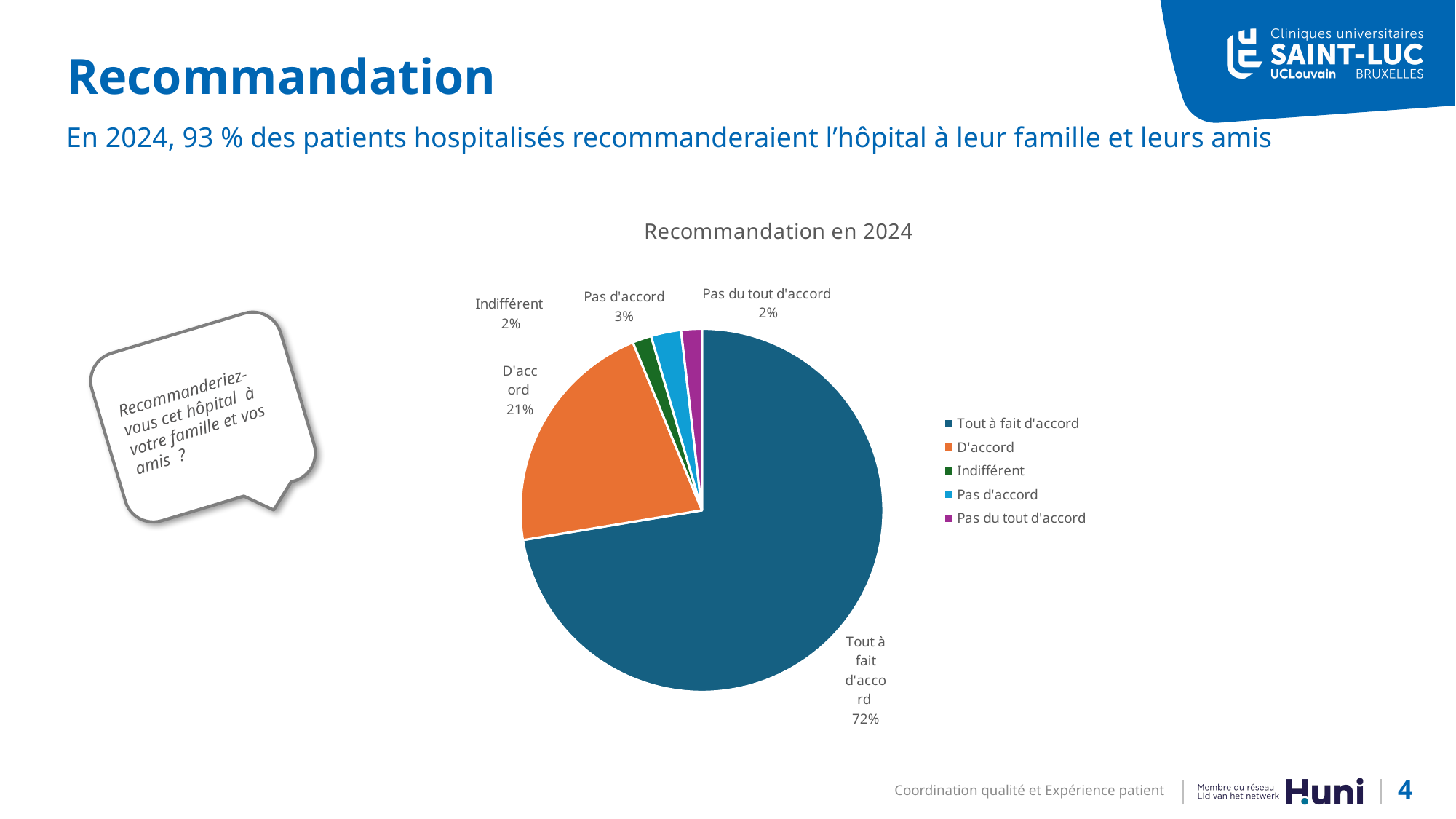
What share of the pie is labelled "Indifférent"? 2% What share of the pie is labelled "D'accord"? 21% How many categories does the legend list? 5 Which colour represents "Pas du tout d'accord" in the legend? purple What kind of chart is shown on the slide? pie chart What share of the pie is labelled "Tout à fait d'accord"? 72% What is the title of the chart? Recommandation en 2024 Which slice is larger, "D'accord" or "Pas d'accord"? D'accord What is the combined share of "Tout à fait d'accord" and "D'accord"? 93% Which category has the largest slice of the pie? Tout à fait d'accord What is the difference in percentage points between "Tout à fait d'accord" and "D'accord"? 51